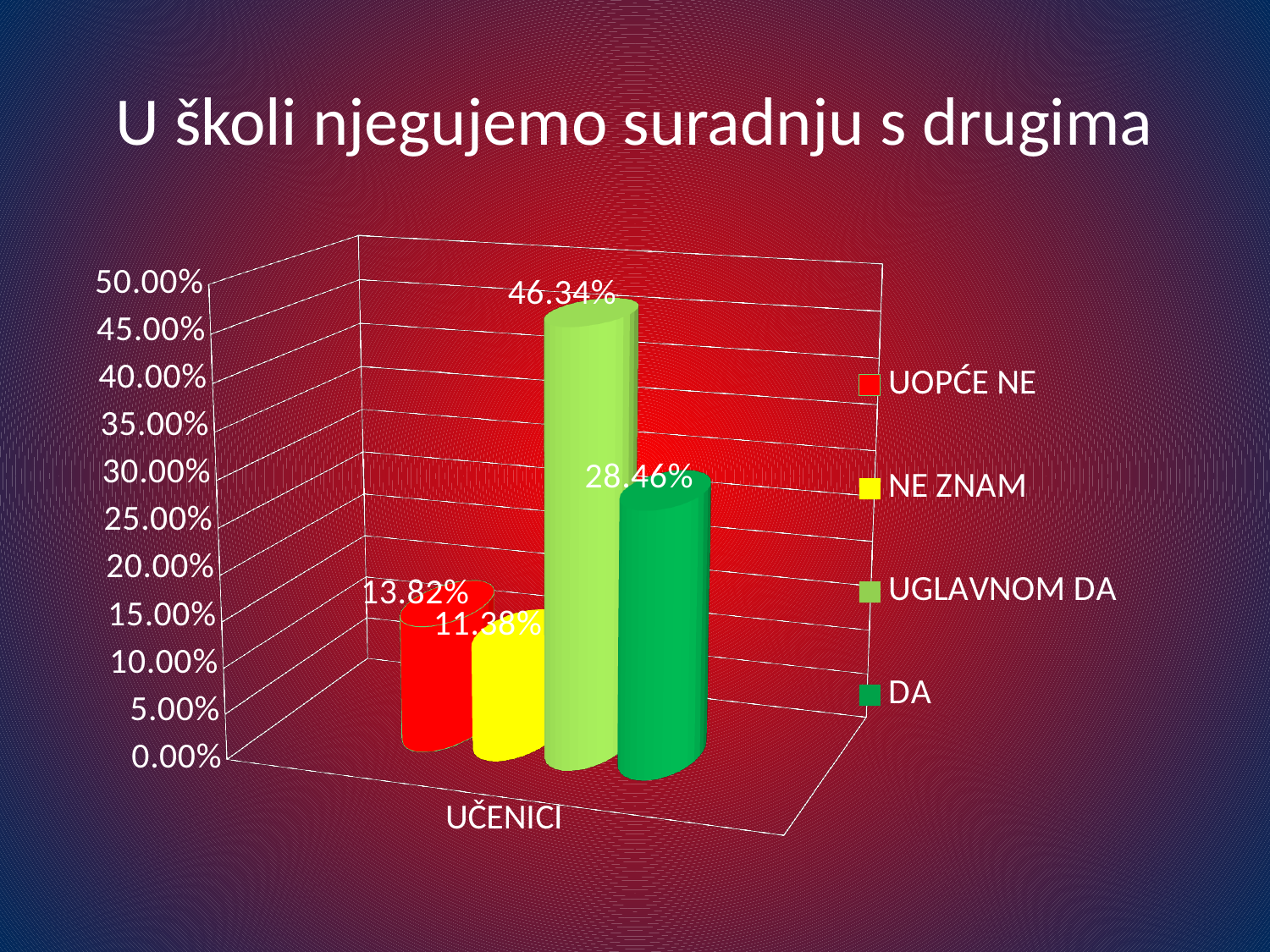
What is the value for NE ZNAM? 11.38% How many series does the legend list? 4 What is the value for UOPĆE NE? 13.82% Which series has the highest value? UGLAVNOM DA What is the difference between the values for UOPĆE NE and NE ZNAM? 2.44% What is the title of the slide? U školi njegujemo suradnju s drugima What is the value for UGLAVNOM DA? 46.34% What is the value for DA? 28.46% What kind of chart is shown on the slide? Bar chart What is the difference between the values for UGLAVNOM DA and DA? 17.88% Which series has the lowest value? NE ZNAM Which is larger, the value for DA or the value for UOPĆE NE? DA